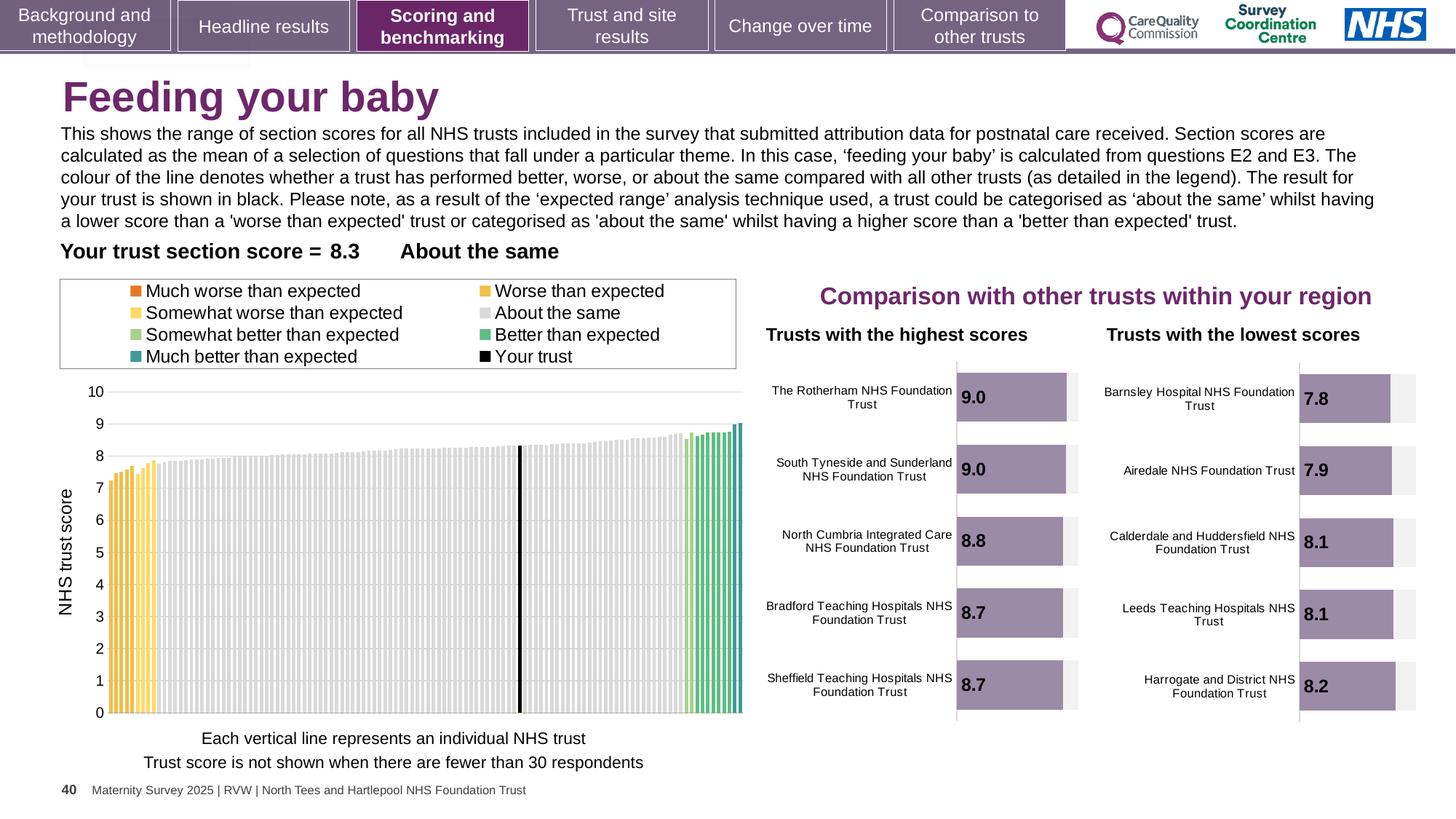
How many entries does the legend above the large chart on the left list? 8 In the 'Trusts with the highest scores' chart, what is the score for North Cumbria Integrated Care NHS Foundation Trust? 8.8 In the large chart on the left, is the value for the black 'Your trust' bar greater or less than 9? less What kind of chart is the large chart on the left with the y-axis labelled 'NHS trust score'? Bar chart In the large chart on the left, do the trust scores rise or fall from left to right along the x axis? Rise In the 'Trusts with the lowest scores' chart, which trust has the highest score? Harrogate and District NHS Foundation Trust In the 'Trusts with the lowest scores' chart, what is the difference between the scores of Harrogate and District NHS Foundation Trust and Barnsley Hospital NHS Foundation Trust? 0.4 How many trusts are shown in the 'Trusts with the highest scores' chart? 5 In the 'Trusts with the lowest scores' chart, what is the score for Airedale NHS Foundation Trust? 7.9 In the 'Trusts with the highest scores' chart, which has the higher score: North Cumbria Integrated Care NHS Foundation Trust or Bradford Teaching Hospitals NHS Foundation Trust? North Cumbria Integrated Care NHS Foundation Trust In the 'Trusts with the highest scores' chart, what is the difference between the scores of The Rotherham NHS Foundation Trust and Sheffield Teaching Hospitals NHS Foundation Trust? 0.3 In the 'Trusts with the lowest scores' chart, which trust has the lowest score? Barnsley Hospital NHS Foundation Trust